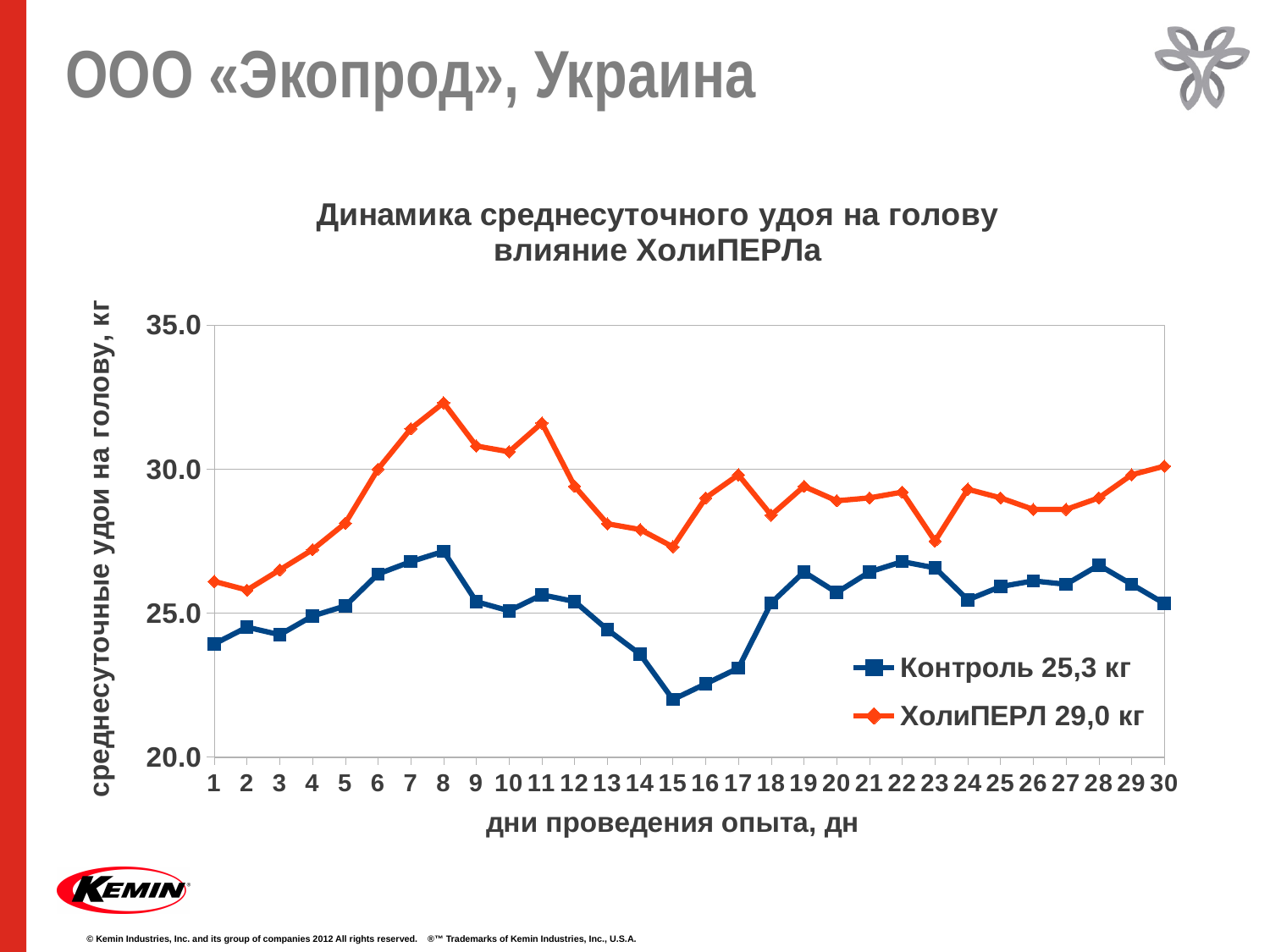
What kind of chart is shown on the slide? Line chart Does the ХолиПЕРЛ series rise or fall from day 1 to day 8? rise On which day does the ХолиПЕРЛ series reach its highest value? 8 Is the value for ХолиПЕРЛ on day 8 greater or less than 30.0? greater Is the value for ХолиПЕРЛ on day 15 greater or less than 30.0? less Is the value for Контроль on day 15 greater or less than 25.0? less Does the Контроль series rise or fall from day 8 to day 15? fall How many days (points) are plotted along the x axis? 30 On which day does the Контроль series reach its lowest value? 15 Which series has the higher value on day 15, Контроль or ХолиПЕРЛ? ХолиПЕРЛ What are the two legend entries of the chart? Контроль 25,3 кг and ХолиПЕРЛ 29,0 кг How many series does the legend list? 2